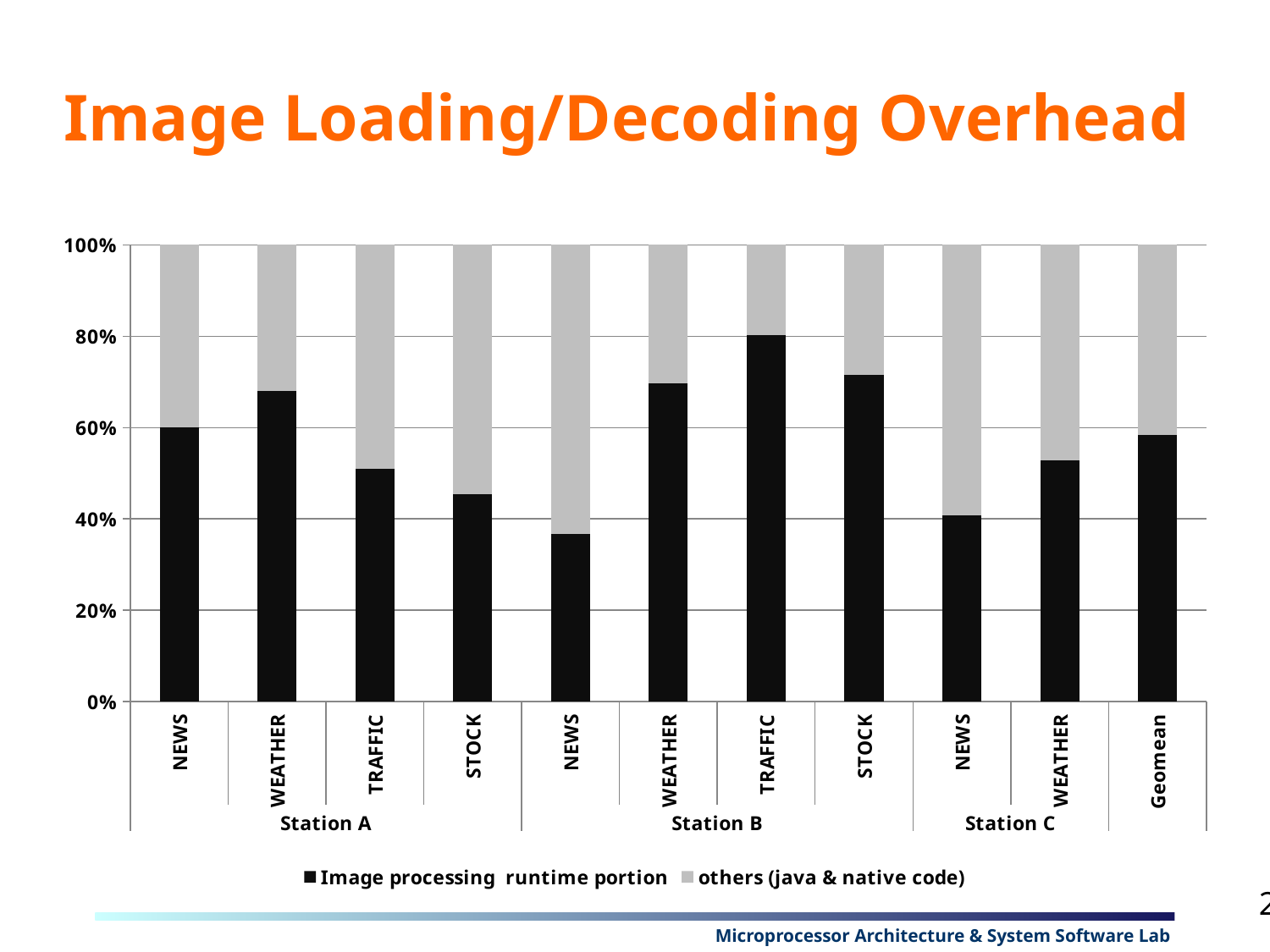
How many bars are plotted in the chart? 11 What is the title of the chart on the slide? Image Loading/Decoding Overhead Is the Image processing runtime portion for Station A WEATHER greater or less than 60%? greater Which has a larger Image processing runtime portion, Station A TRAFFIC or Station B TRAFFIC? Station B TRAFFIC Which bar has the largest Image processing runtime portion? Station B TRAFFIC What kind of chart is shown on the slide? Stacked bar chart Is the Image processing runtime portion for Station B TRAFFIC greater or less than 60%? greater Is the Image processing runtime portion for Station A STOCK greater or less than 60%? less How many series does the legend list? 2 What is the total of the stacked bar for Geomean? 100% Which has a larger Image processing runtime portion, Station A NEWS or Station A STOCK? Station A NEWS